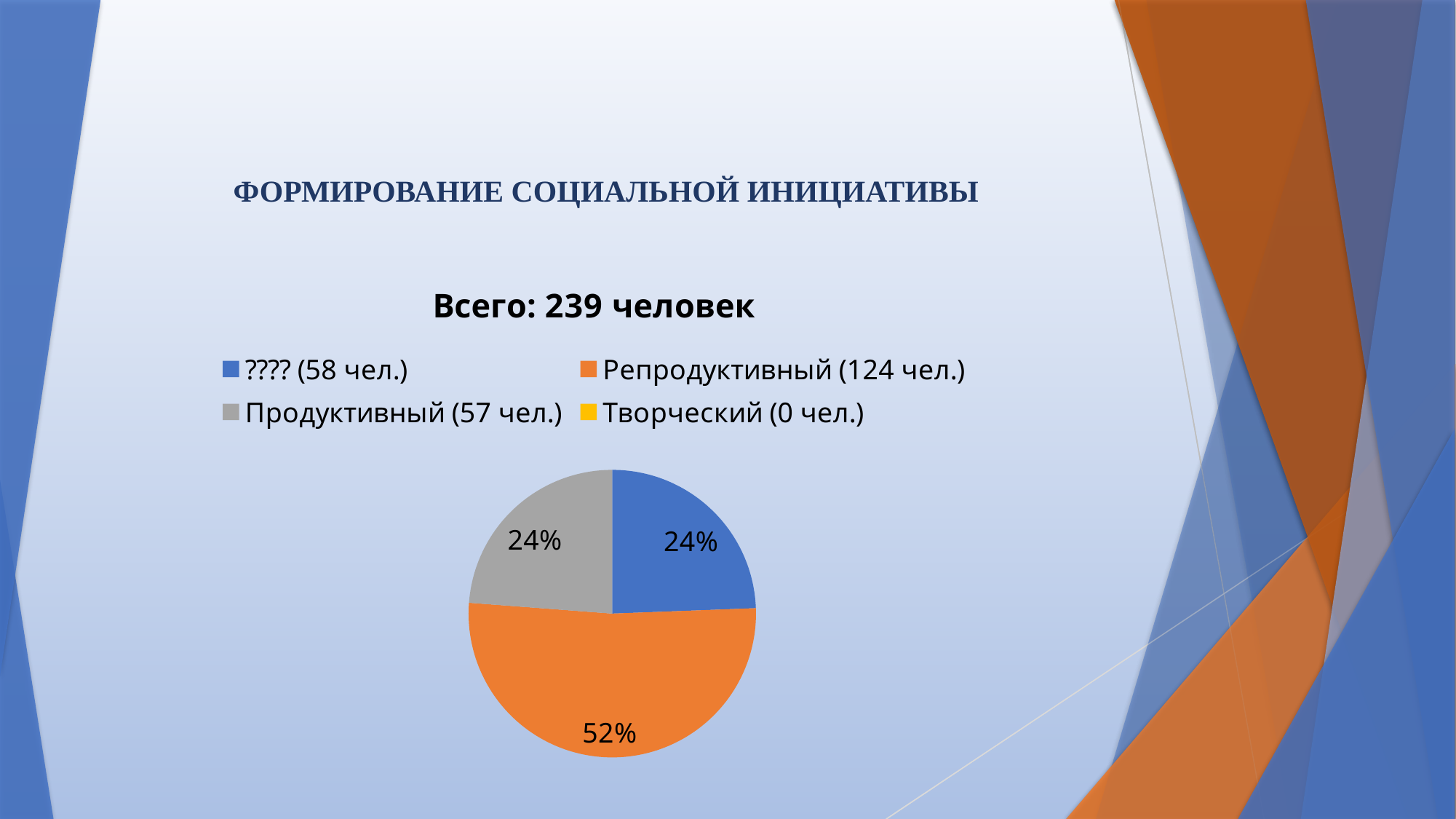
According to the legend, how many people are in the Творческий category? 0 чел. Which is larger, the slice for Репродуктивный or the slice for Продуктивный? Репродуктивный What colour represents Репродуктивный in the pie chart? orange Which category has the largest slice of the pie? Репродуктивный What is the title of the chart? Всего: 239 человек Which category has the smallest number of people according to the legend? Творческий According to the legend, how many people are in the Репродуктивный category? 124 чел. What share of the pie does Репродуктивный take? 52% How many categories does the legend list? 4 What kind of chart is shown on the slide? pie chart What share of the pie does Продуктивный take? 24% What is the difference in percentage points between the Репродуктивный slice and the Продуктивный slice? 28%